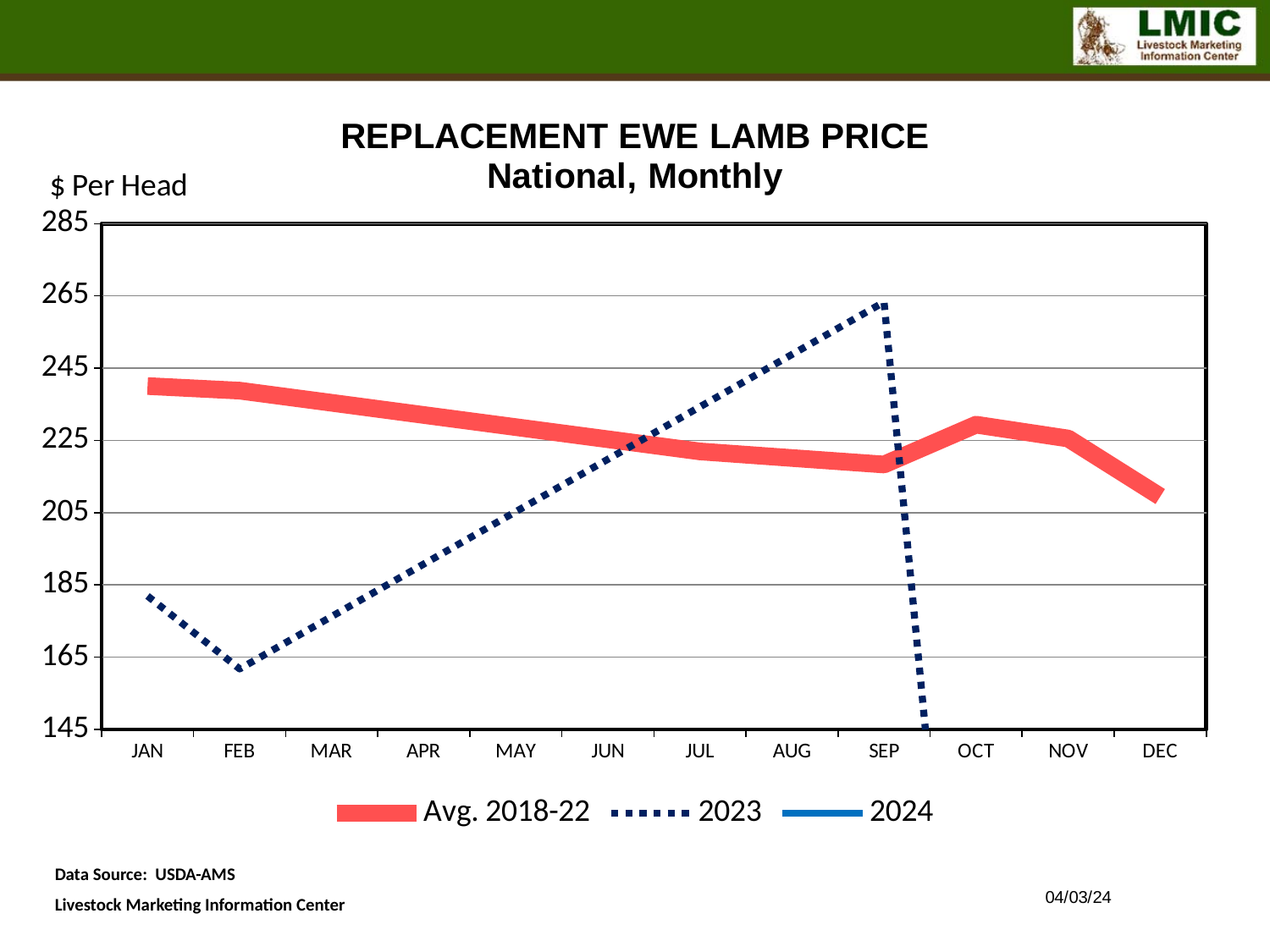
In which month is the Avg. 2018-22 series highest? JAN In which month does the 2023 series reach its lowest value? FEB In which month is the Avg. 2018-22 series lowest? DEC What kind of chart is shown on the slide? line chart In which month does the 2023 series reach its highest value? SEP Is the Avg. 2018-22 value for DEC greater or less than 225? less Is the 2023 value for SEP greater or less than 245? greater How many series does the legend list? 3 How many months are shown along the x axis? 12 In JAN, which series has the higher value, Avg. 2018-22 or 2023? Avg. 2018-22 Does the 2023 series rise or fall from FEB to SEP? rise Is the 2023 value for FEB greater or less than 185? less